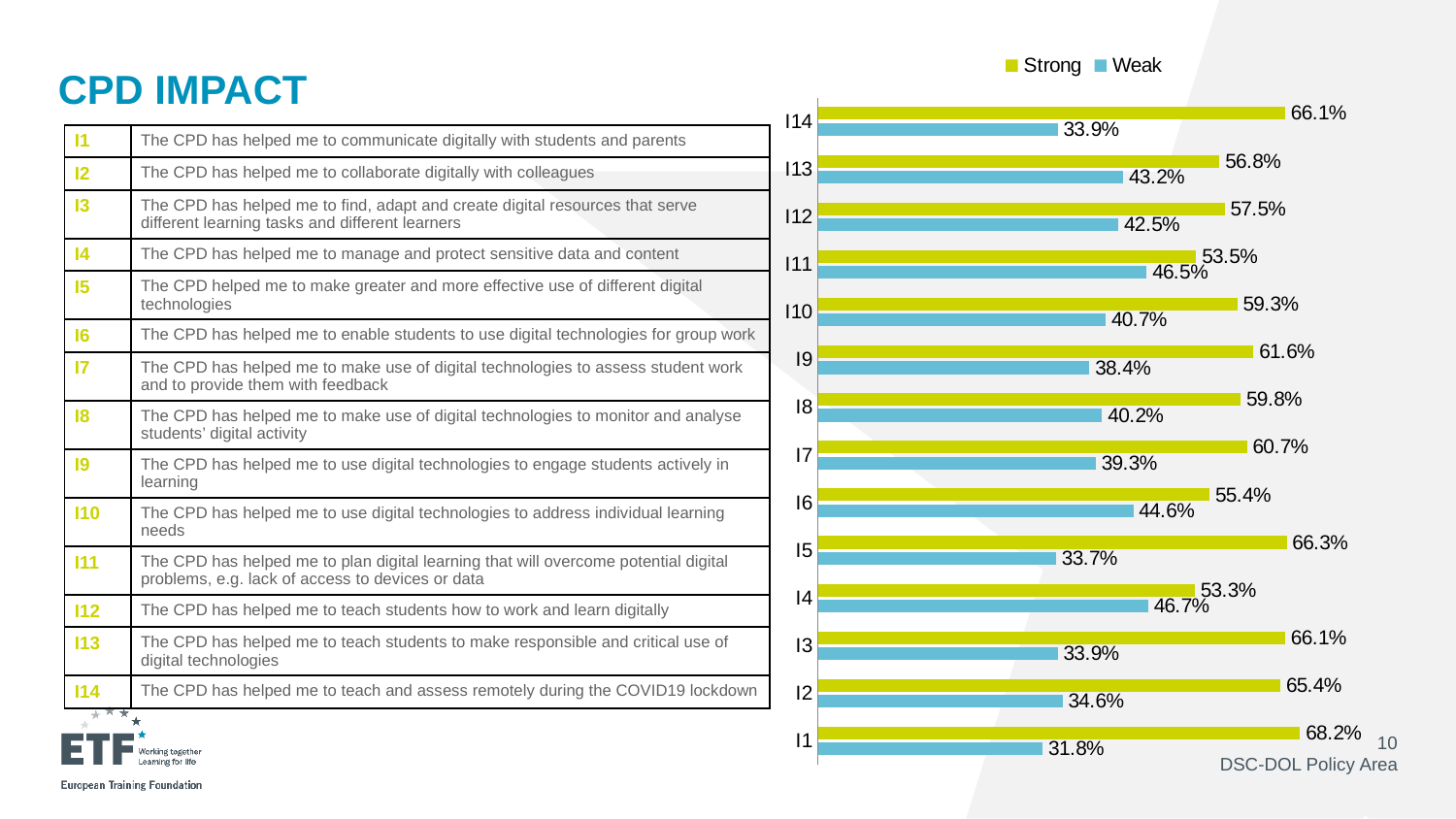
What are the two series named in the chart legend? Strong and Weak What type of chart is shown on the slide? bar chart What is the difference between the Strong and Weak values for I5? 32.6% Which category has the lowest Weak value? I1 Which is larger, the Strong value for I13 or the Strong value for I12? I12 Which category has the highest Weak value? I4 What is the Weak value for I11? 46.5% How many categories are plotted on the chart? 14 How many series does the chart legend list? 2 Which category has the highest Strong value? I1 What is the Strong value for I9? 61.6% What is the Strong value for I1? 68.2%